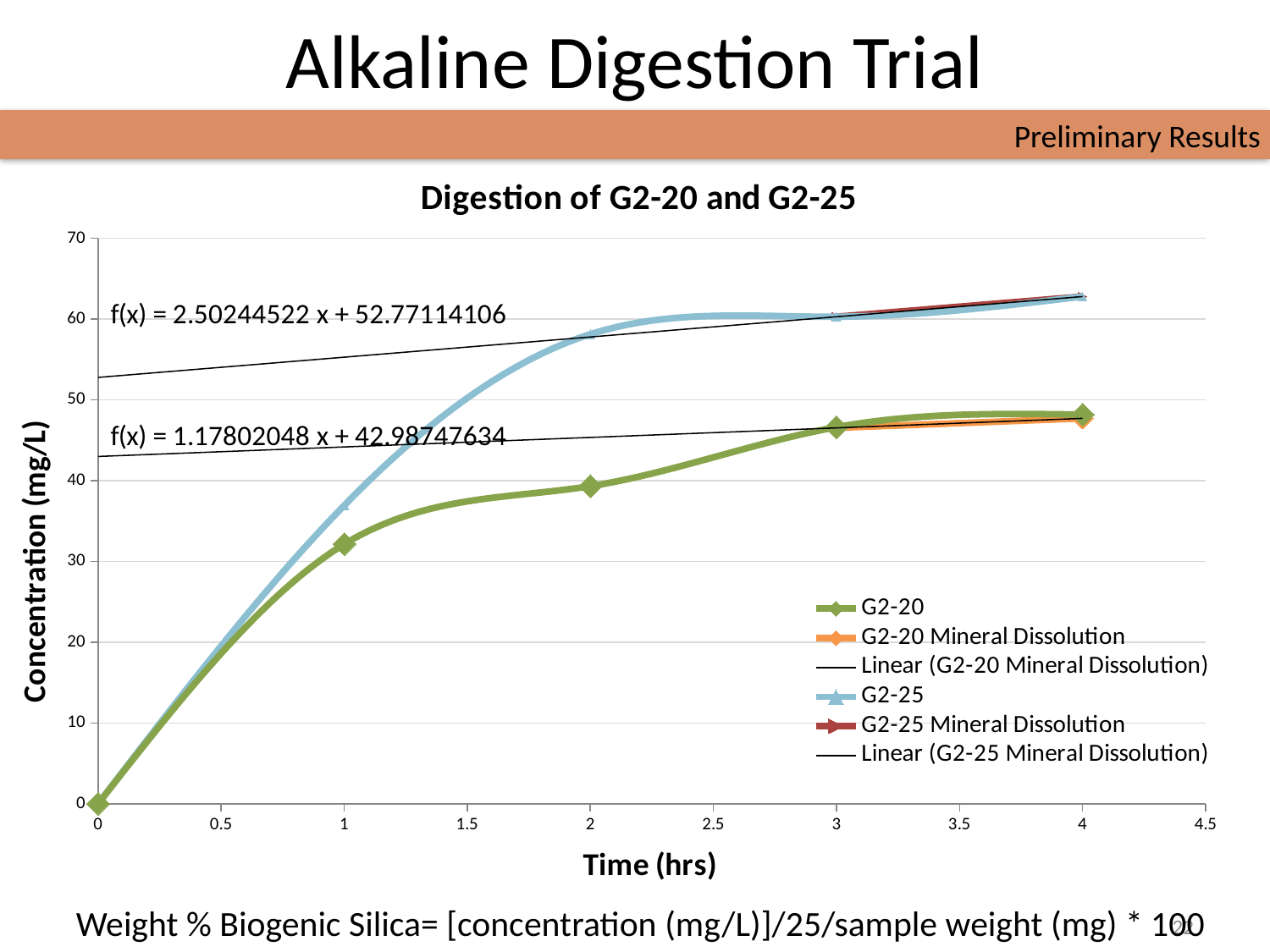
Does the concentration for G2-20 rise or fall as time increases from 0 to 4 hrs? Rise Which series reaches the highest concentration on the chart? G2-25 (tied with G2-25 Mineral Dissolution, both ending at the same top value) How many data points are marked on the G2-20 series? 5 What is the title of the chart? Digestion of G2-20 and G2-25 How many series does the chart legend list? 6 Is the concentration for G2-25 at 1 hr greater or less than 40 mg/L? less What is the trendline equation shown for the upper (G2-25 Mineral Dissolution) linear fit? f(x) = 2.50244522 x + 52.77114106 Is the concentration for G2-25 at 4 hrs greater or less than 60 mg/L? greater At 2 hrs, which series has the higher concentration, G2-20 or G2-25? G2-25 Is the concentration for G2-25 at 2 hrs greater or less than 50 mg/L? greater What kind of chart is shown on the slide? Line chart